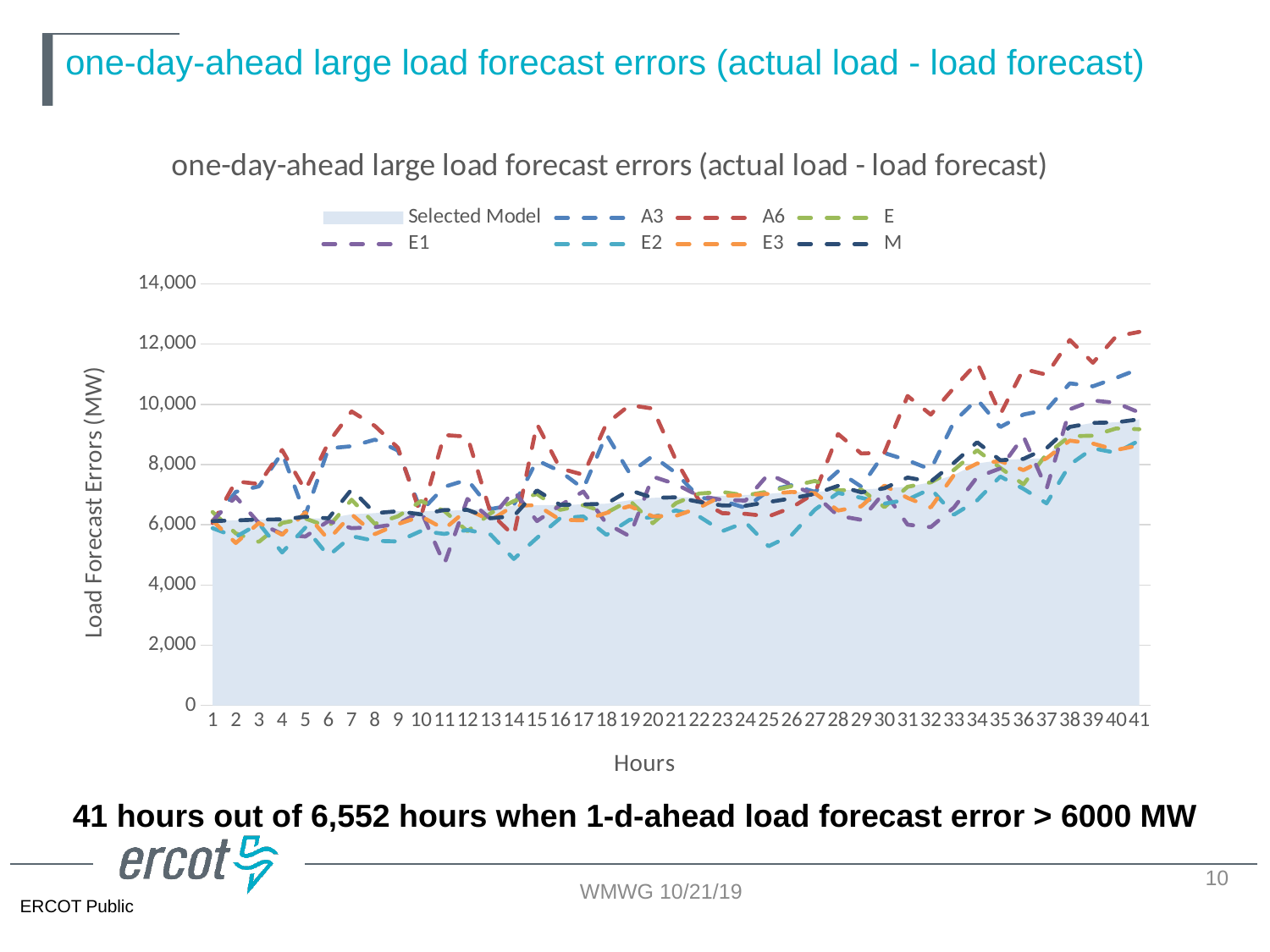
Which series has the highest value at hour 19? A6 Is the value of E2 at hour 14 greater or less than 6,000? less How many hours are plotted along the x axis of the chart? 41 Is the value of the Selected Model at hour 41 greater or less than 10,000? less Is the value of A6 at hour 41 greater or less than 12,000? greater Which series has the highest value at hour 41? A6 What is the label of the y axis of the chart? Load Forecast Errors (MW) How many series does the chart legend list? 8 At hour 41, which series has the larger value, A6 or E2? A6 What is the label of the x axis of the chart? Hours Does the Selected Model series generally rise or fall from hour 1 to hour 41? rise